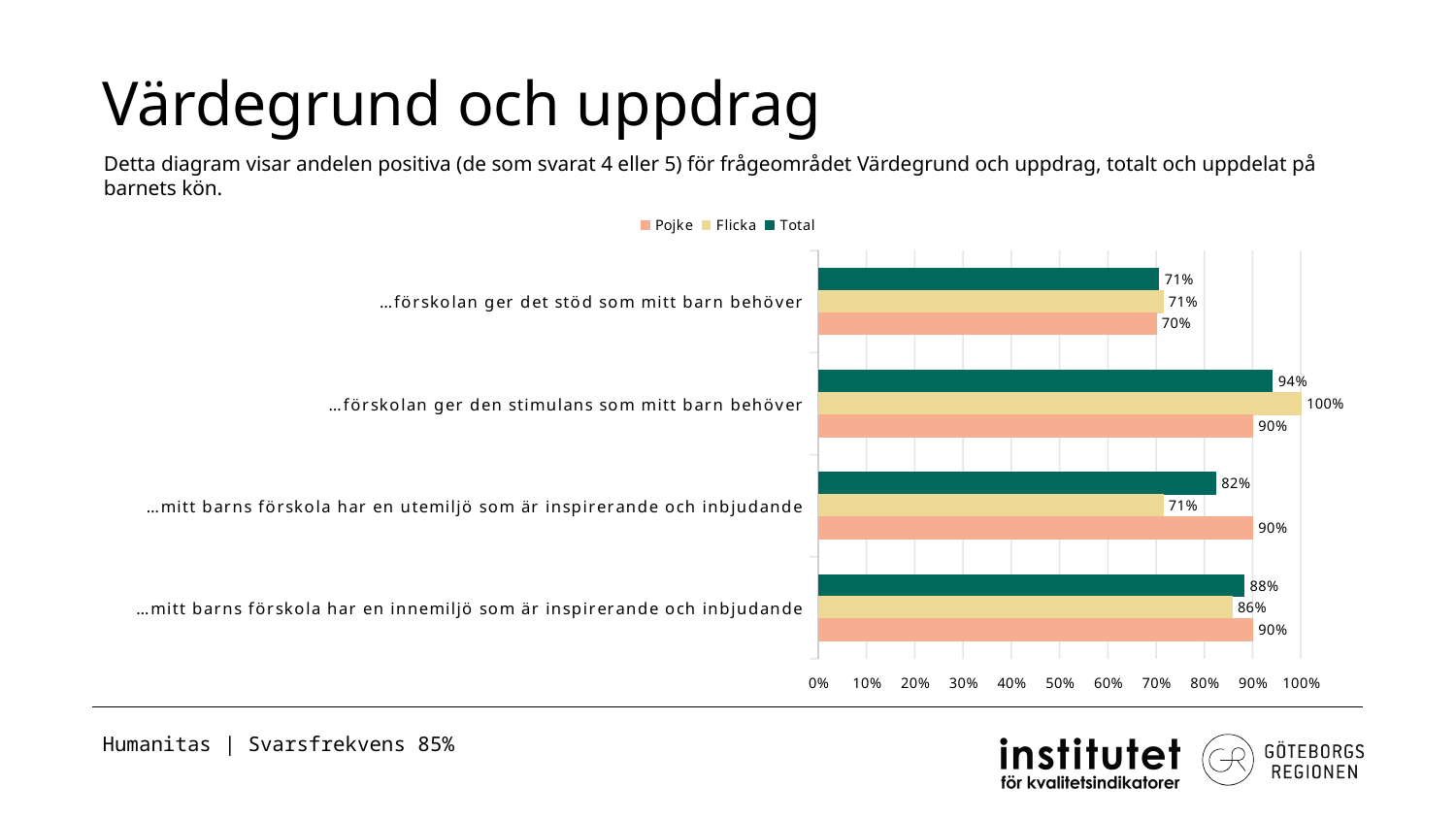
What kind of chart is shown on the slide? Bar chart Which category has the highest Total value? …förskolan ger den stimulans som mitt barn behöver What is the Flicka value for "…mitt barns förskola har en utemiljö som är inspirerande och inbjudande"? 71% What is the difference between the Pojke and Flicka values for "…mitt barns förskola har en utemiljö som är inspirerande och inbjudande"? 19 percentage points How many categories are shown on the y axis of the chart? 4 What is the Total value for "…förskolan ger den stimulans som mitt barn behöver"? 94% Which series is shown in green in the chart? Total For "…förskolan ger den stimulans som mitt barn behöver", which is larger, the Pojke value or the Flicka value? Flicka What is the Pojke value for "…förskolan ger det stöd som mitt barn behöver"? 70% How many series does the legend list? 3 What is the Flicka value for "…mitt barns förskola har en innemiljö som är inspirerande och inbjudande"? 86% Which category has the lowest Total value? …förskolan ger det stöd som mitt barn behöver